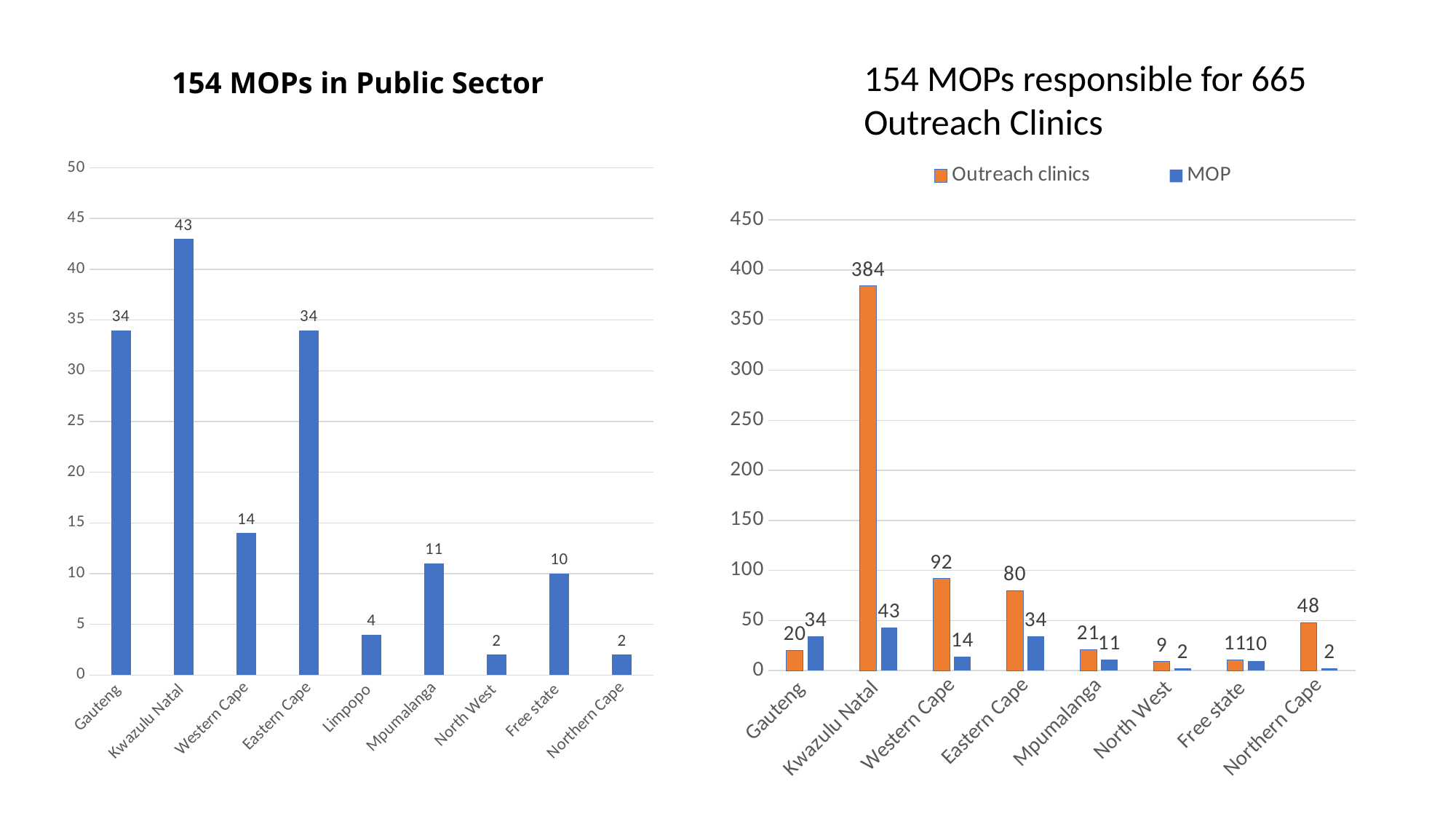
What type of chart is the chart titled '154 MOPs responsible for 665 Outreach Clinics'? Bar chart In the chart titled '154 MOPs in Public Sector', which province has the highest value? Kwazulu Natal In the chart titled '154 MOPs responsible for 665 Outreach Clinics', what is the Outreach clinics value for Kwazulu Natal? 384 In the chart titled '154 MOPs in Public Sector', what is the difference between the values for Kwazulu Natal and Western Cape? 29 In the chart titled '154 MOPs in Public Sector', which is larger, the value for Mpumalanga or the value for Free state? Mpumalanga In the chart titled '154 MOPs in Public Sector', what is the value for Kwazulu Natal? 43 In the chart titled '154 MOPs responsible for 665 Outreach Clinics', how many series does the legend list? 2 In the chart titled '154 MOPs responsible for 665 Outreach Clinics', what is the difference between the Outreach clinics values for Western Cape and Eastern Cape? 12 In the chart titled '154 MOPs responsible for 665 Outreach Clinics', which province has the lowest Outreach clinics value? North West In the chart titled '154 MOPs in Public Sector', how many provinces are shown on the x axis? 9 In the chart titled '154 MOPs in Public Sector', what is the value for Limpopo? 4 In the chart titled '154 MOPs responsible for 665 Outreach Clinics', what is the Outreach clinics value for Northern Cape? 48